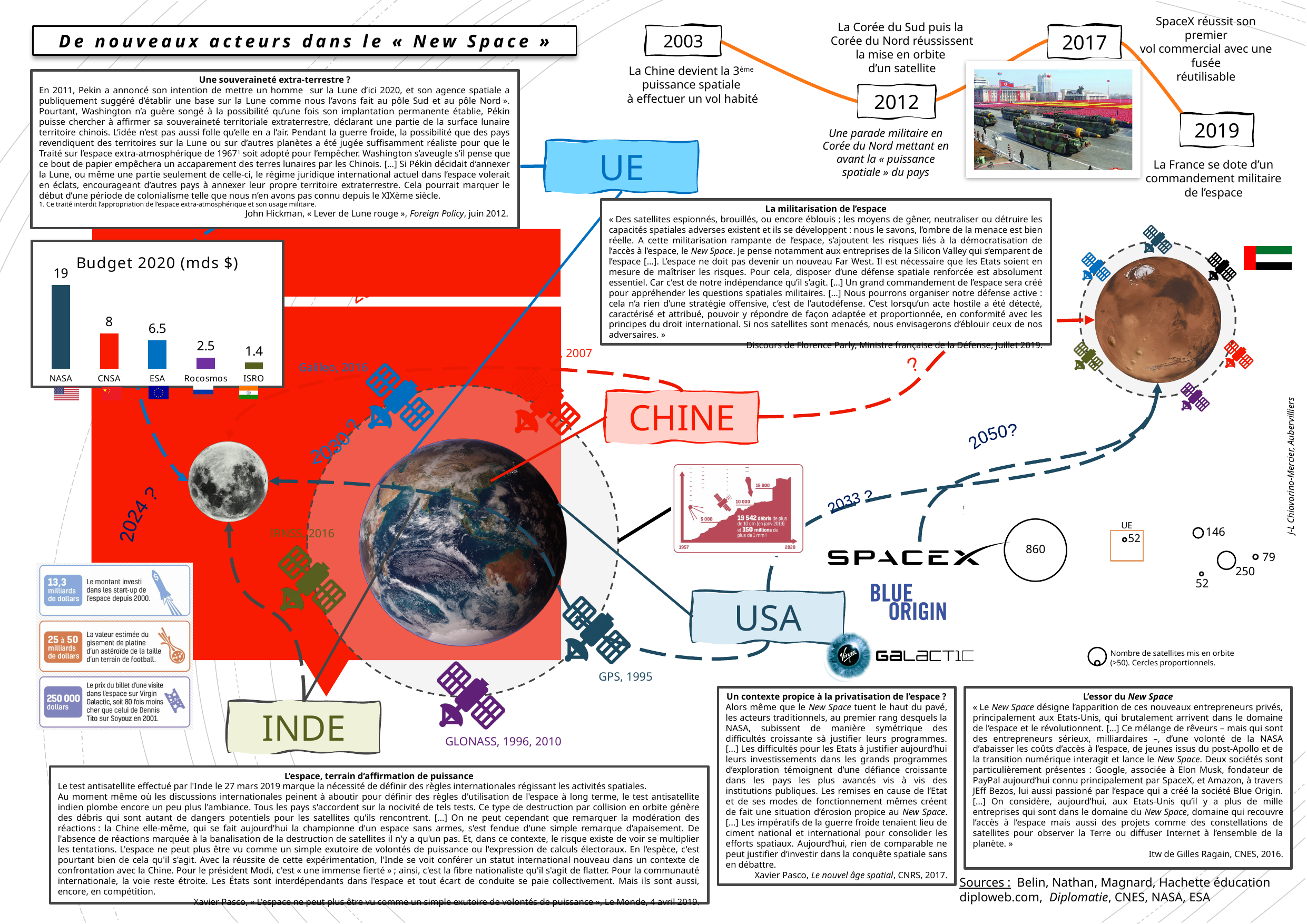
In the 'Budget 2020 (mds $)' chart, what is the value for Rocosmos? 2.5 How many agencies are shown in the 'Budget 2020 (mds $)' chart? 5 In the 'Budget 2020 (mds $)' chart, what is the value for ISRO? 1.4 In the 'Budget 2020 (mds $)' chart, what is the difference between the NASA and CNSA values? 11 In the 'Budget 2020 (mds $)' chart, what colour is the CNSA bar? red In the 'Budget 2020 (mds $)' chart, which is larger, the value for CNSA or the value for ESA? CNSA In the 'Budget 2020 (mds $)' chart, which agency has the highest budget? NASA In the 'Budget 2020 (mds $)' chart, what is the value for ESA? 6.5 In the 'Budget 2020 (mds $)' chart, what is the difference between the CNSA and ESA values? 1.5 In the 'Budget 2020 (mds $)' chart, which agency has the lowest budget? ISRO In the 'Budget 2020 (mds $)' chart, what is the value for NASA? 19 What kind of chart is the 'Budget 2020 (mds $)' chart? bar chart